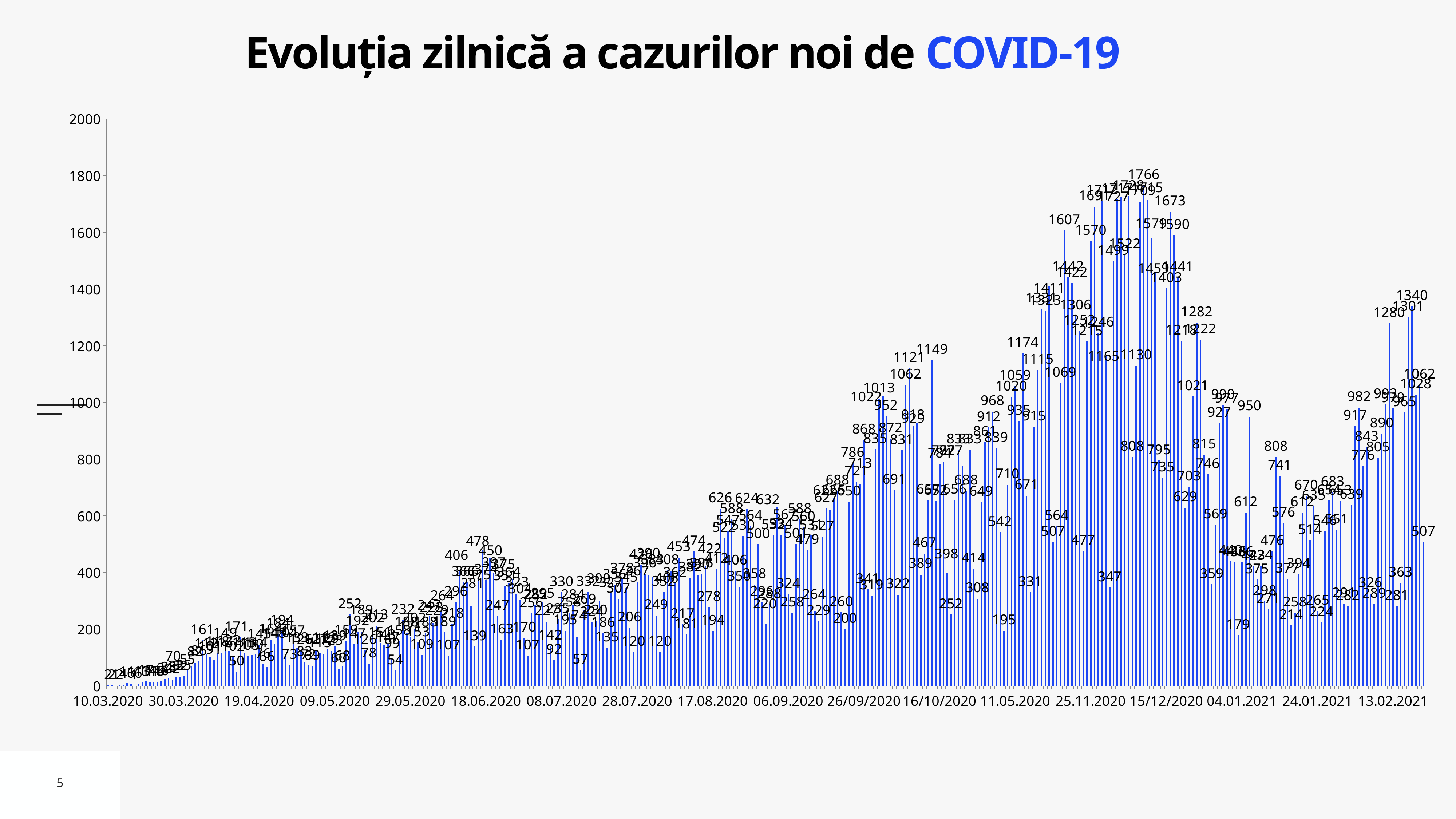
What is the first date label on the x axis? 10.03.2020 What is the highest tick value on the y axis? 2000 What is the title of the chart? Evoluția zilnică a cazurilor noi de COVID-19 What is the difference between the bars labelled 1340 and 1280? 60 What is the difference between the highest value, 1766, and the value labelled 1607? 159 Is the last bar on the right of the chart greater or less than 600? less What kind of chart is shown on the slide? bar chart Is the highest bar on the chart greater or less than 1600? greater What is the highest daily value shown on the chart? 1766 What is the value of the last bar on the right of the chart? 507 Which is larger, the bar labelled 1766 or the bar labelled 1673? 1766 Do the daily values generally rise or fall from 10.03.2020 to 13.02.2021? rise